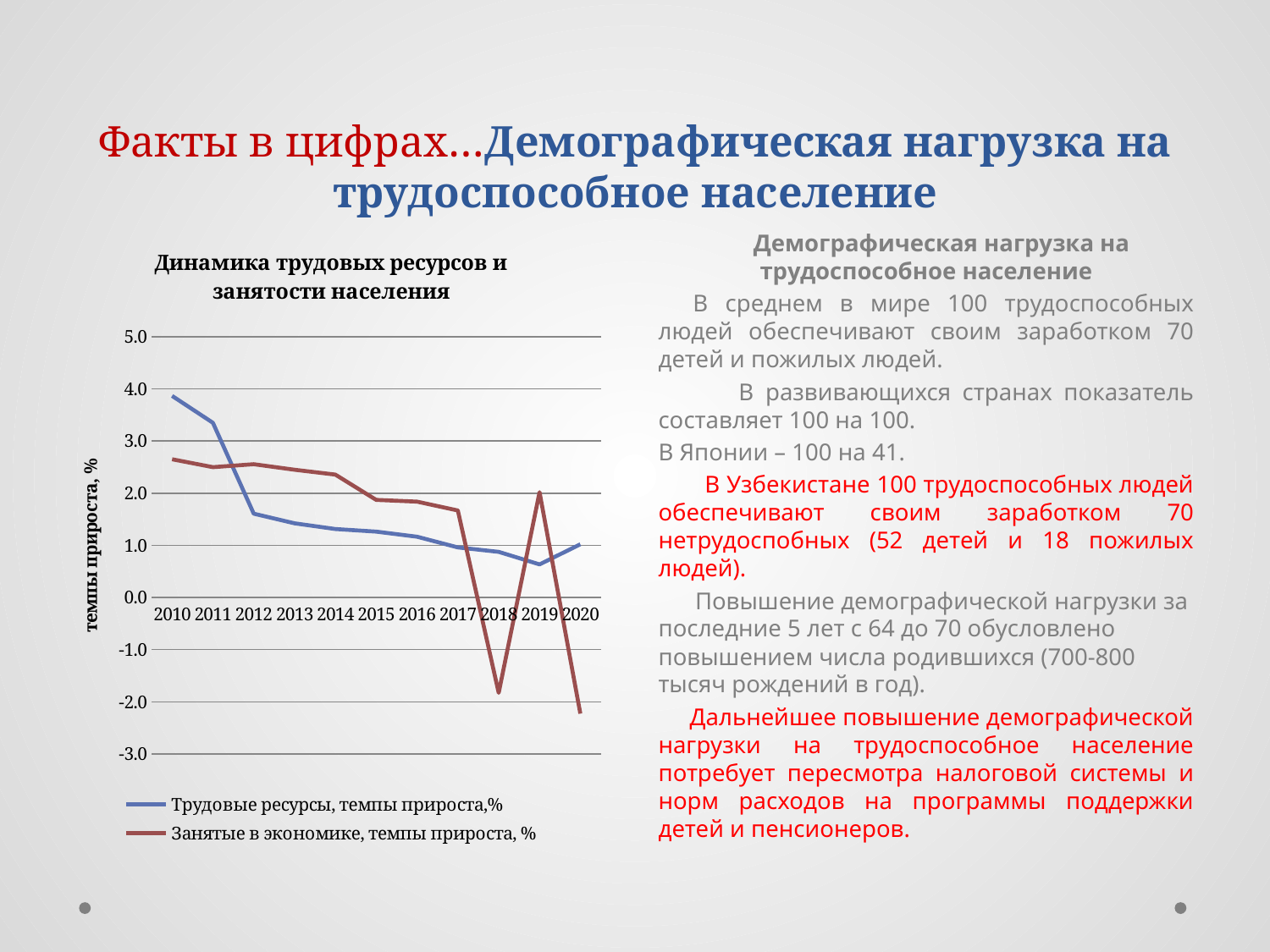
What kind of chart is shown on the slide? line chart In 2015, which series has the larger value: 'Трудовые ресурсы, темпы прироста,%' or 'Занятые в экономике, темпы прироста, %'? Занятые в экономике, темпы прироста, % How many series does the chart legend list? 2 What is the label of the vertical axis of the chart? темпы прироста, % In 2018, which series has the larger value: 'Трудовые ресурсы, темпы прироста,%' or 'Занятые в экономике, темпы прироста, %'? Трудовые ресурсы, темпы прироста,% Is the value for 'Трудовые ресурсы, темпы прироста,%' in 2010 greater or less than 3.0? greater How many years are plotted along the x axis of the chart? 11 Is the value for 'Занятые в экономике, темпы прироста, %' in 2020 greater or less than -2.0? less Is the value for 'Занятые в экономике, темпы прироста, %' in 2018 greater or less than -1.0? less In which year is the value for 'Трудовые ресурсы, темпы прироста,%' highest? 2010 What is the title of the chart? Динамика трудовых ресурсов и занятости населения